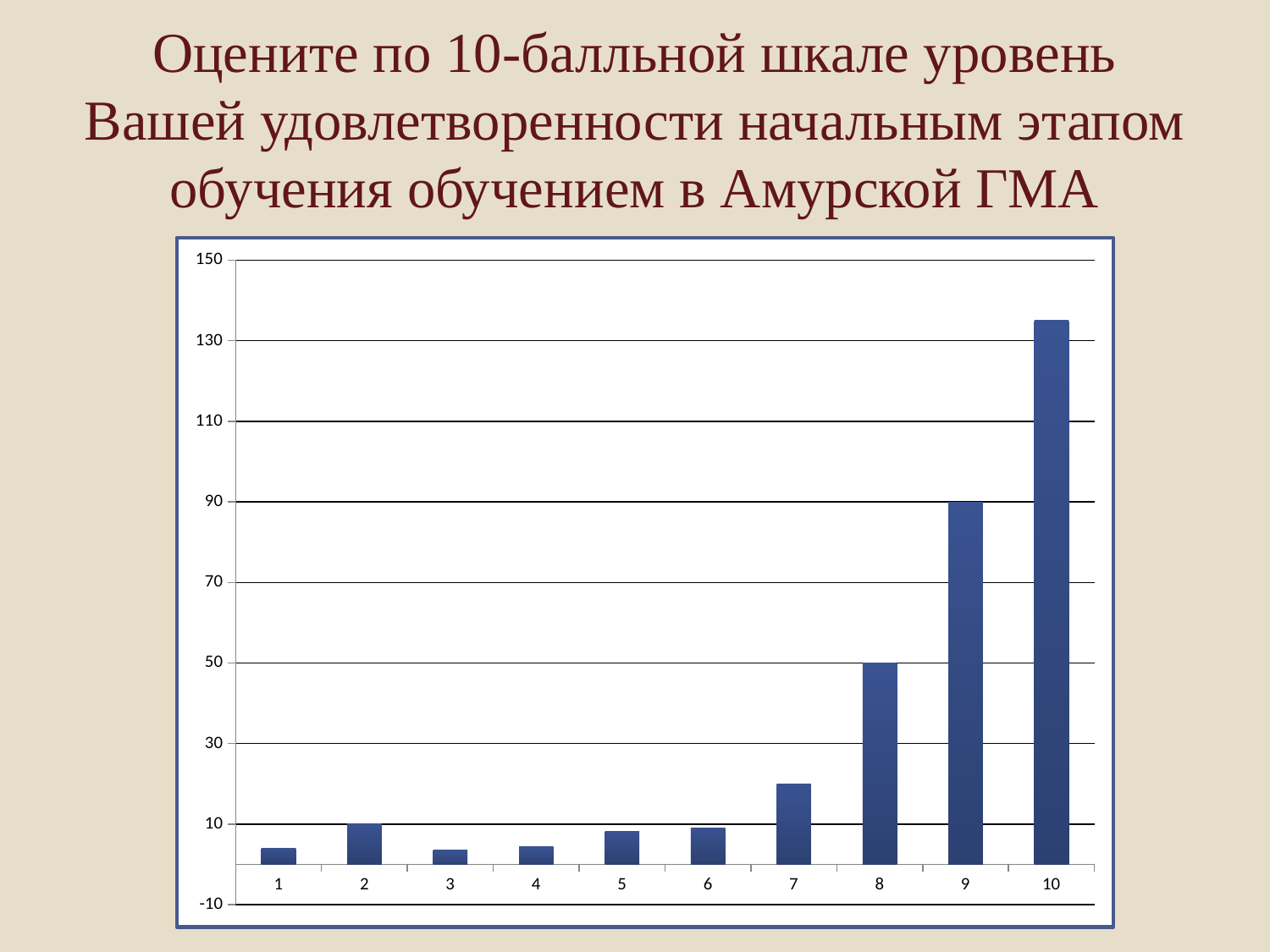
What is the value for category 9? 90 Which has a larger value, category 7 or category 6? 7 Which has a larger value, category 9 or category 8? 9 What is the value for category 8? 50 What kind of chart is shown on the slide? bar chart How many categories are shown on the x axis of the chart? 10 Is the value for category 1 greater or less than 10? less Which category has the highest bar? 10 Is the value for category 10 greater or less than 130? greater Do the values generally rise or fall from category 6 to category 10? rise What is the difference between the values for category 9 and category 8? 40 Is the value for category 7 greater or less than 30? less